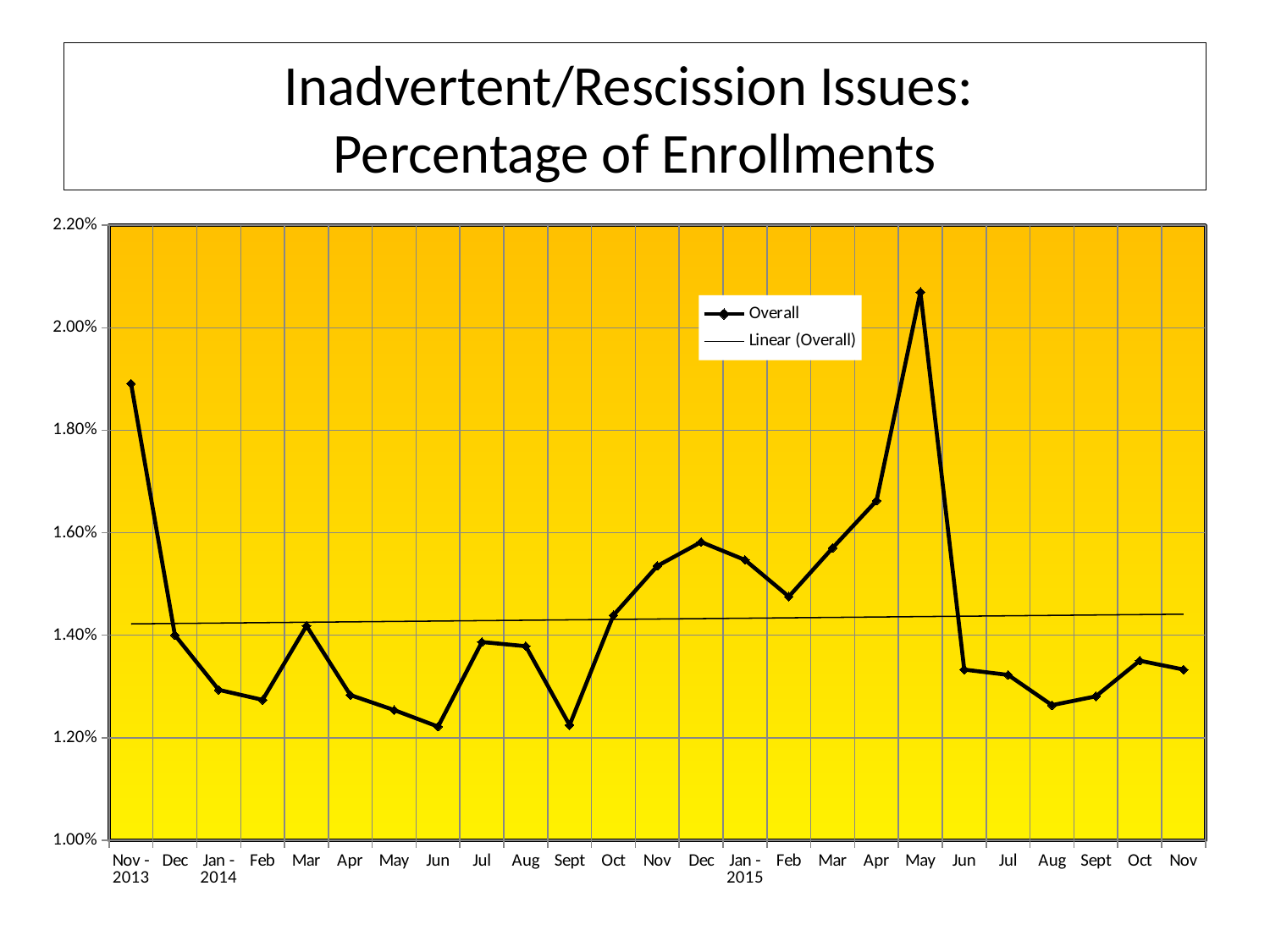
Does the Overall line rise or fall from May 2015 to Jun 2015? fall How many data points are plotted on the Overall line? 25 Is the Overall value for Apr 2015 greater or less than 1.60%? greater Which has the larger Overall value, Apr 2014 or Apr 2015? Apr 2015 What is the title of the chart? Inadvertent/Rescission Issues: Percentage of Enrollments What kind of chart is shown on the slide? line chart Is the Overall value for Nov 2013 greater or less than 1.80%? greater How many entries does the legend list? 2 Is the Overall value for Sept 2014 greater or less than 1.40%? less Which has the larger Overall value, Nov 2013 or Dec 2013? Nov 2013 In which month is the Overall value highest? May 2015